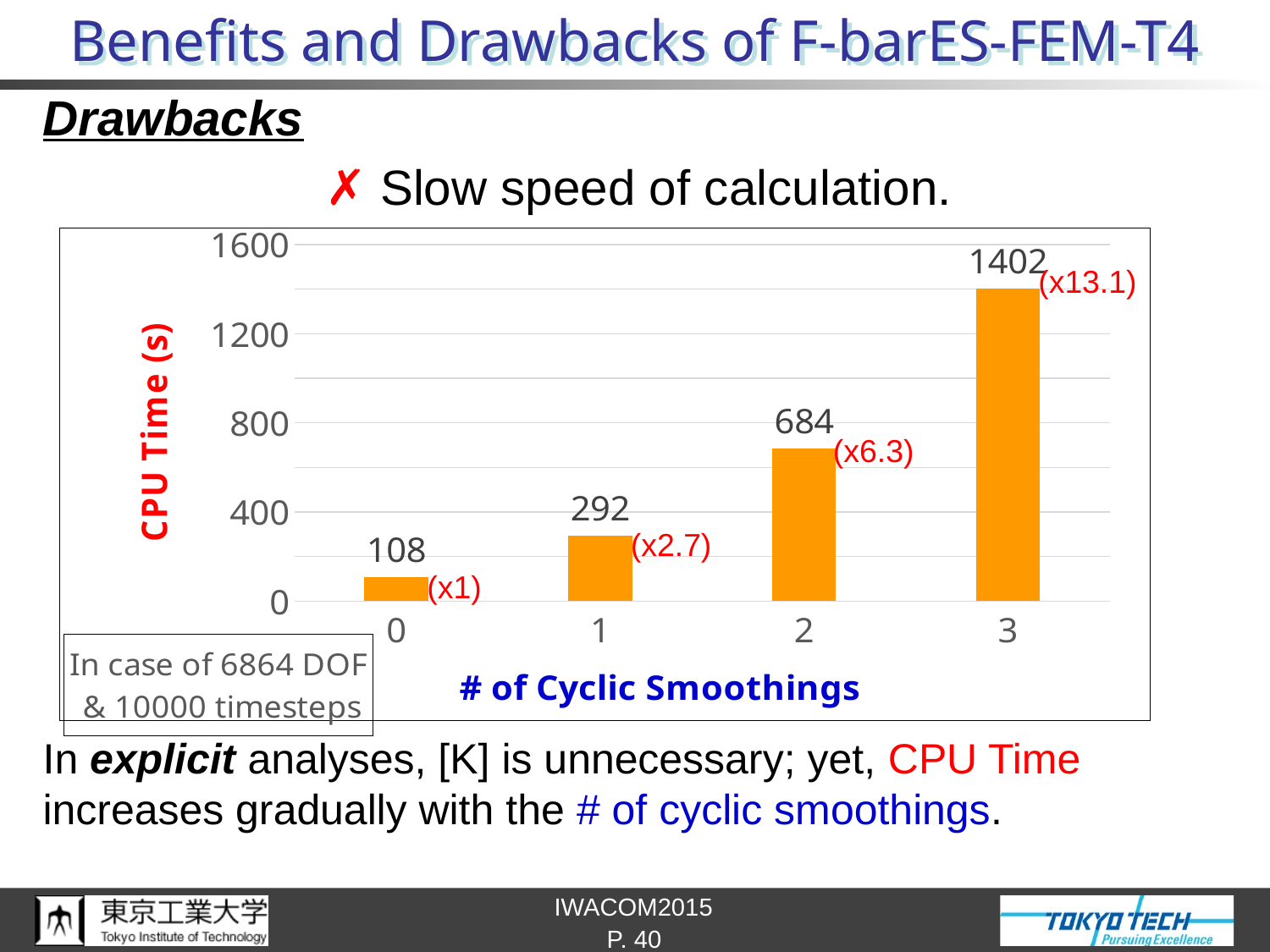
Is the CPU Time for 2 cyclic smoothings greater or less than 800? less What type of chart is shown on the slide? bar chart What is the CPU Time for 2 cyclic smoothings? 684 Which number of cyclic smoothings has the highest CPU Time? 3 What is the label of the x axis of the chart? # of Cyclic Smoothings What is the difference in CPU Time between 1 and 0 cyclic smoothings? 184 What is the difference in CPU Time between 3 and 2 cyclic smoothings? 718 Which has a larger CPU Time, 1 or 2 cyclic smoothings? 2 What is the CPU Time for 3 cyclic smoothings? 1402 Which number of cyclic smoothings has the lowest CPU Time? 0 What is the CPU Time for 0 cyclic smoothings? 108 How many bars are shown in the chart? 4